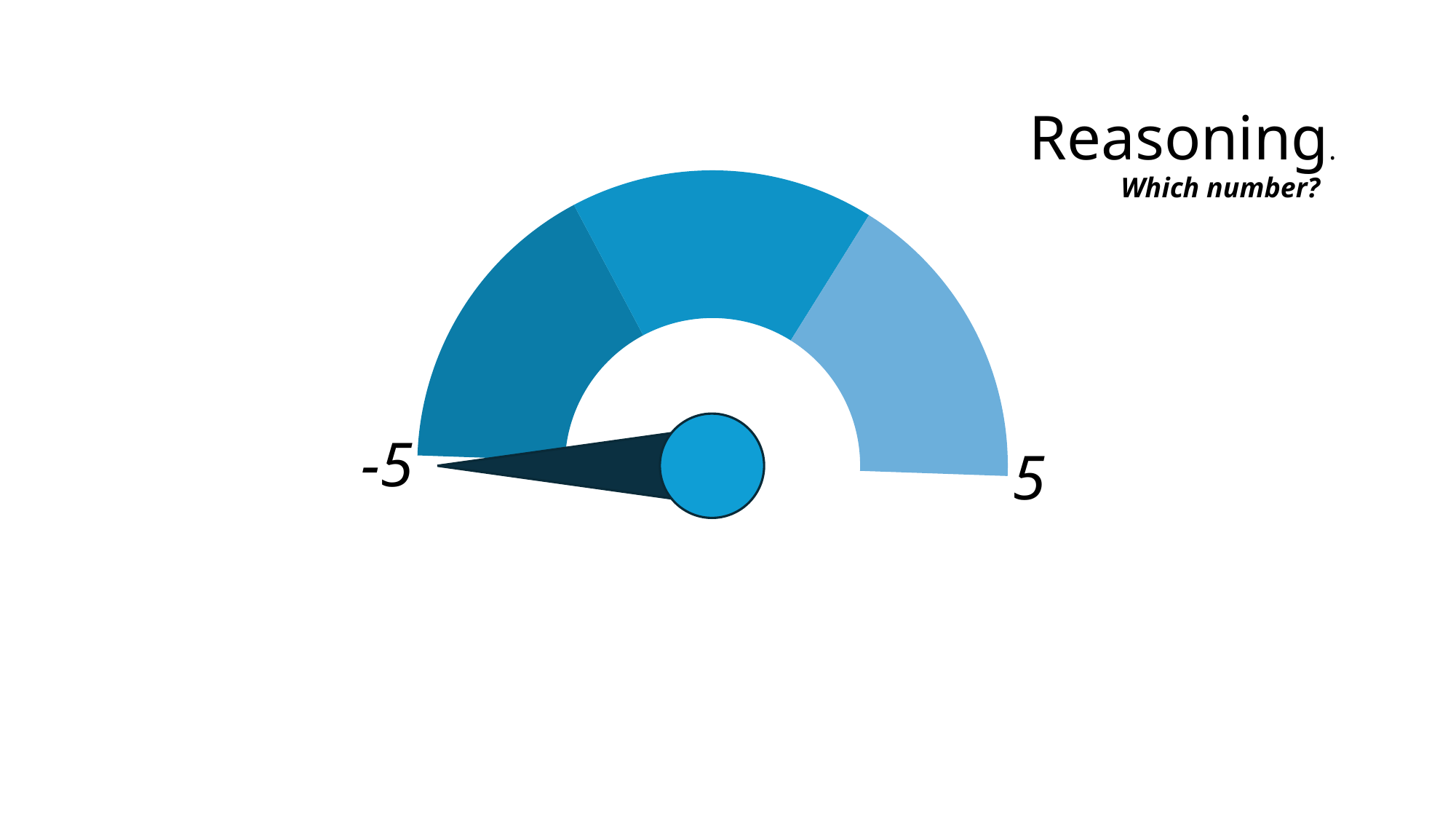
What value does the needle of the gauge point to? -5 What is the lowest value labelled on the gauge scale? -5 How many coloured segments make up the gauge arc? 3 What is the title shown on the slide? Reasoning. What kind of chart is shown on the slide? gauge chart What question is written in italics under the slide title? Which number? What is the difference between the highest and lowest labelled values on the gauge? 10 What is the highest value labelled on the gauge scale? 5 Is the value the needle points to greater or less than 0? less Which labelled end of the gauge is larger, the left end or the right end? the right end (5)